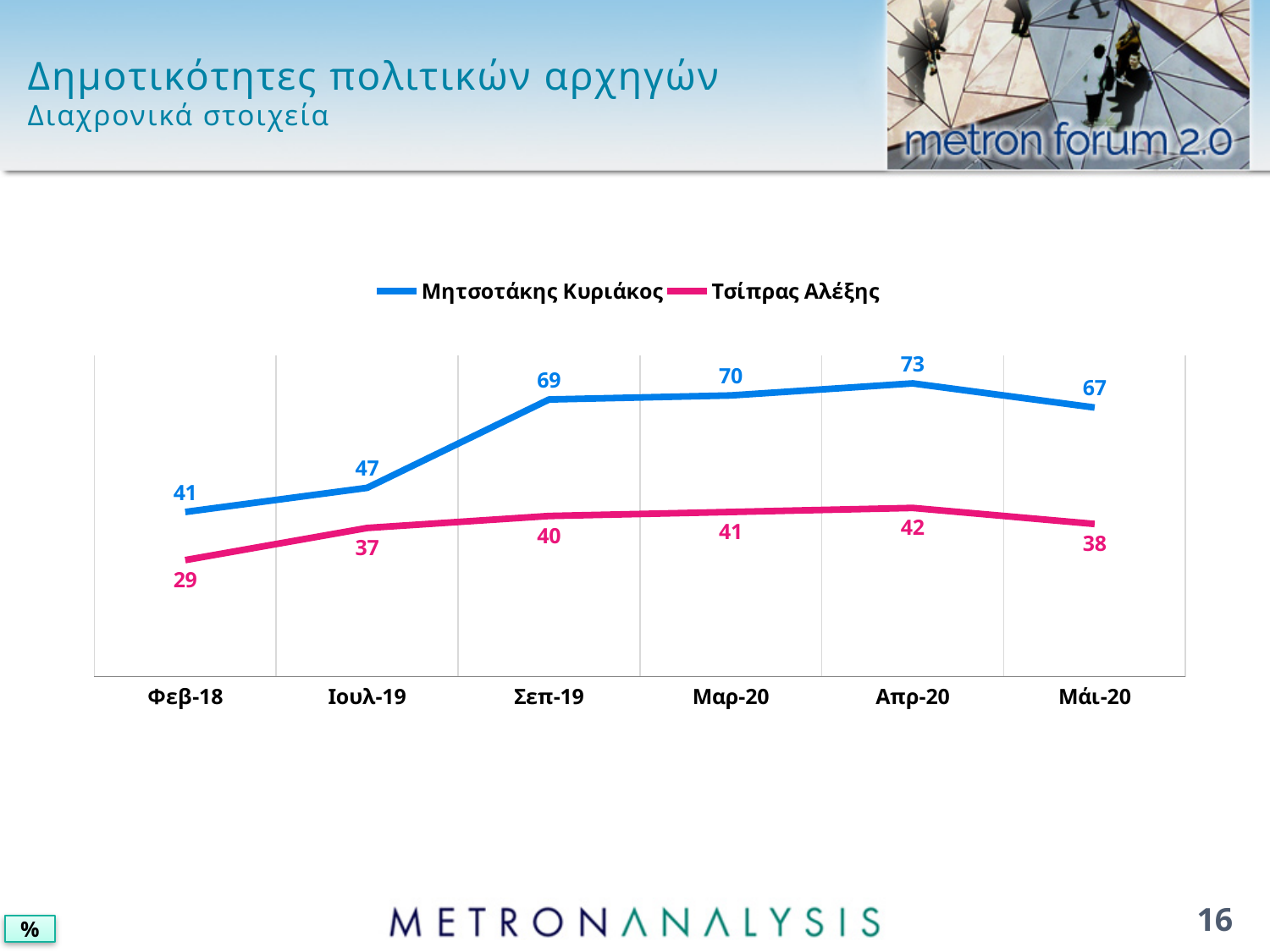
What is the value for Τσίπρας Αλέξης in Μάι-20? 38 What is the value for Μητσοτάκης Κυριάκος in Σεπ-19? 69 What is the difference between Μητσοτάκης Κυριάκος and Τσίπρας Αλέξης in Μαρ-20? 29 What kind of chart is shown on the slide? Line chart In which period does Τσίπρας Αλέξης have his lowest value? Φεβ-18 In which period does Μητσοτάκης Κυριάκος reach his highest value? Απρ-20 Which series has the higher value in Μάι-20, Μητσοτάκης Κυριάκος or Τσίπρας Αλέξης? Μητσοτάκης Κυριάκος How many series does the legend list? 2 What is the value for Μητσοτάκης Κυριάκος in Απρ-20? 73 By how much did the value for Μητσοτάκης Κυριάκος change from Ιουλ-19 to Σεπ-19? 22 How many time periods are shown on the x axis? 6 What is the value for Τσίπρας Αλέξης in Φεβ-18? 29